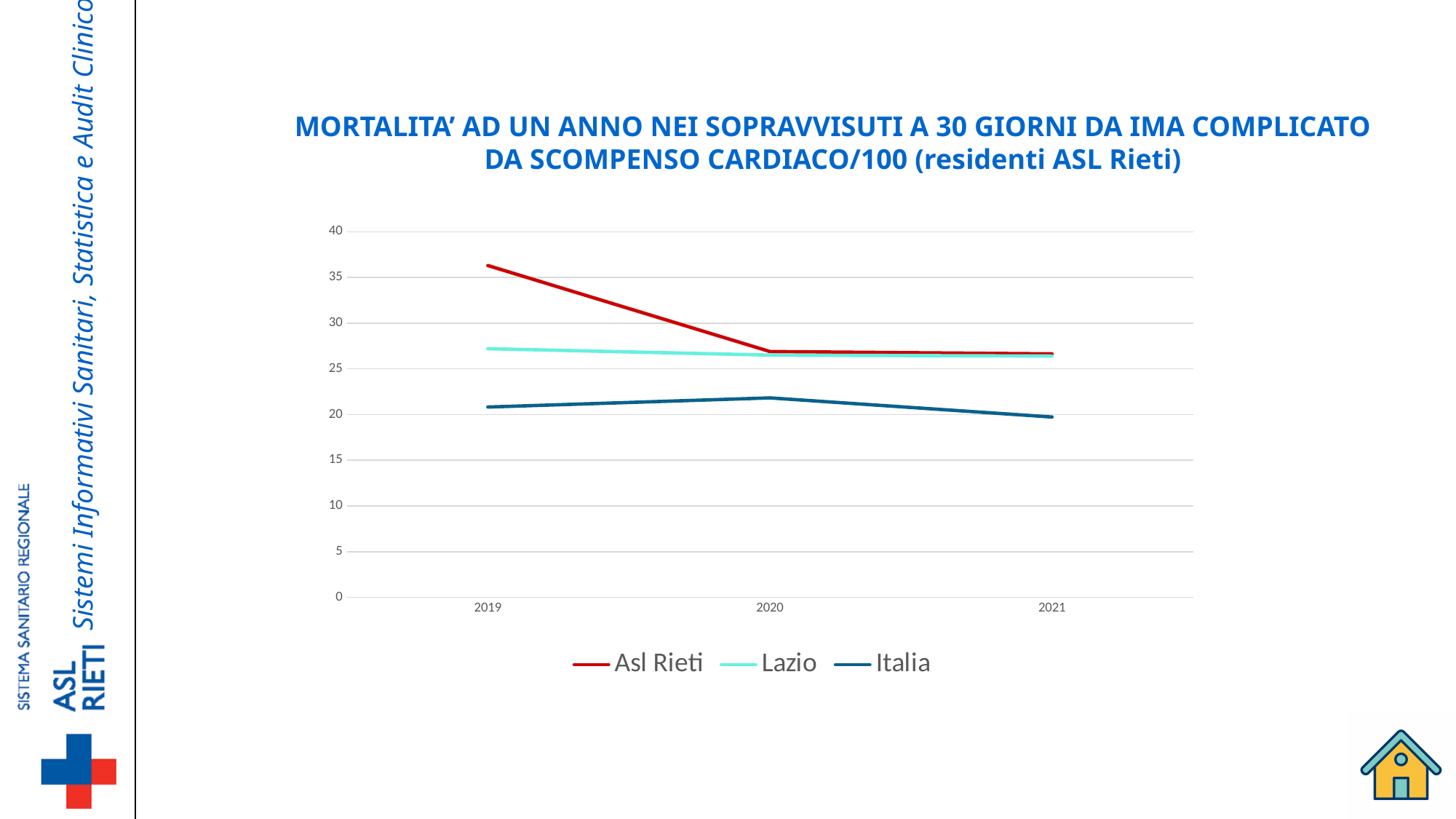
Does the Asl Rieti line rise or fall from 2019 to 2021? fall How many years are shown on the x axis? 3 How many series does the legend list? 3 Which series has the lowest value in 2021? Italia Is the value for Italia in 2021 greater or less than 25? less Which series has the lowest value in 2019? Italia Is the value for Asl Rieti in 2019 greater or less than 35? greater Which series has the highest value in 2019? Asl Rieti Is the value for Lazio in 2019 greater or less than 30? less Which is larger in 2019, the value for Asl Rieti or the value for Italia? Asl Rieti What colour is the Asl Rieti line in the legend? red What kind of chart is shown on the slide? line chart